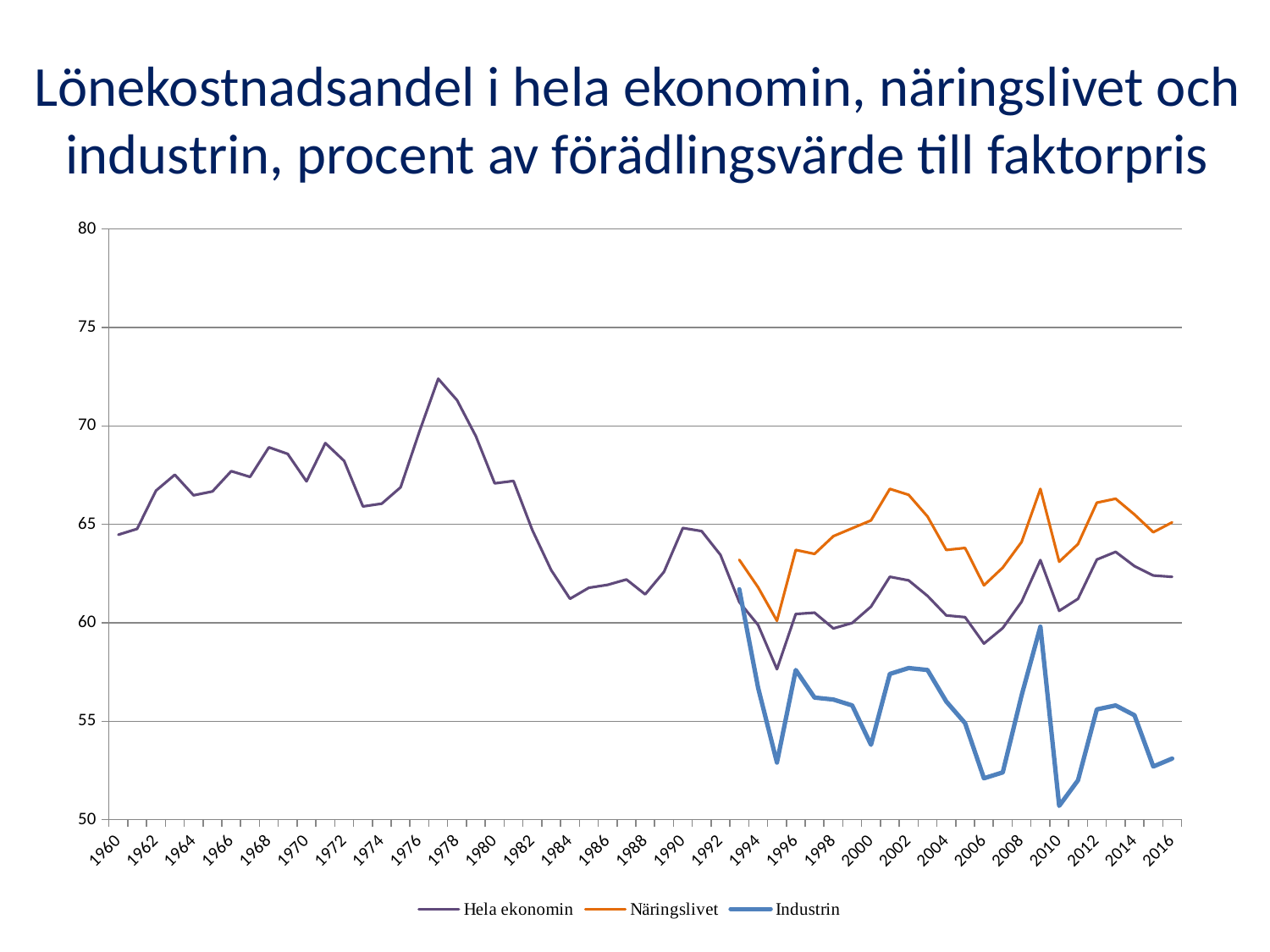
Which series are listed in the legend? Hela ekonomin, Näringslivet, Industrin What kind of chart is shown on the slide? Line chart How many series does the legend list? 3 Is the value for Hela ekonomin in 1995 greater or less than 60? less Is the value for Industrin in 2010 greater or less than 55? less Is the value for Hela ekonomin in 1960 greater or less than 65? less Does the value for Hela ekonomin rise or fall between 1978 and 1984? Fall Which series has the lowest values over the period 1994 to 2016? Industrin Which series is drawn in blue? Industrin In 2016, which series has the higher value, Näringslivet or Industrin? Näringslivet